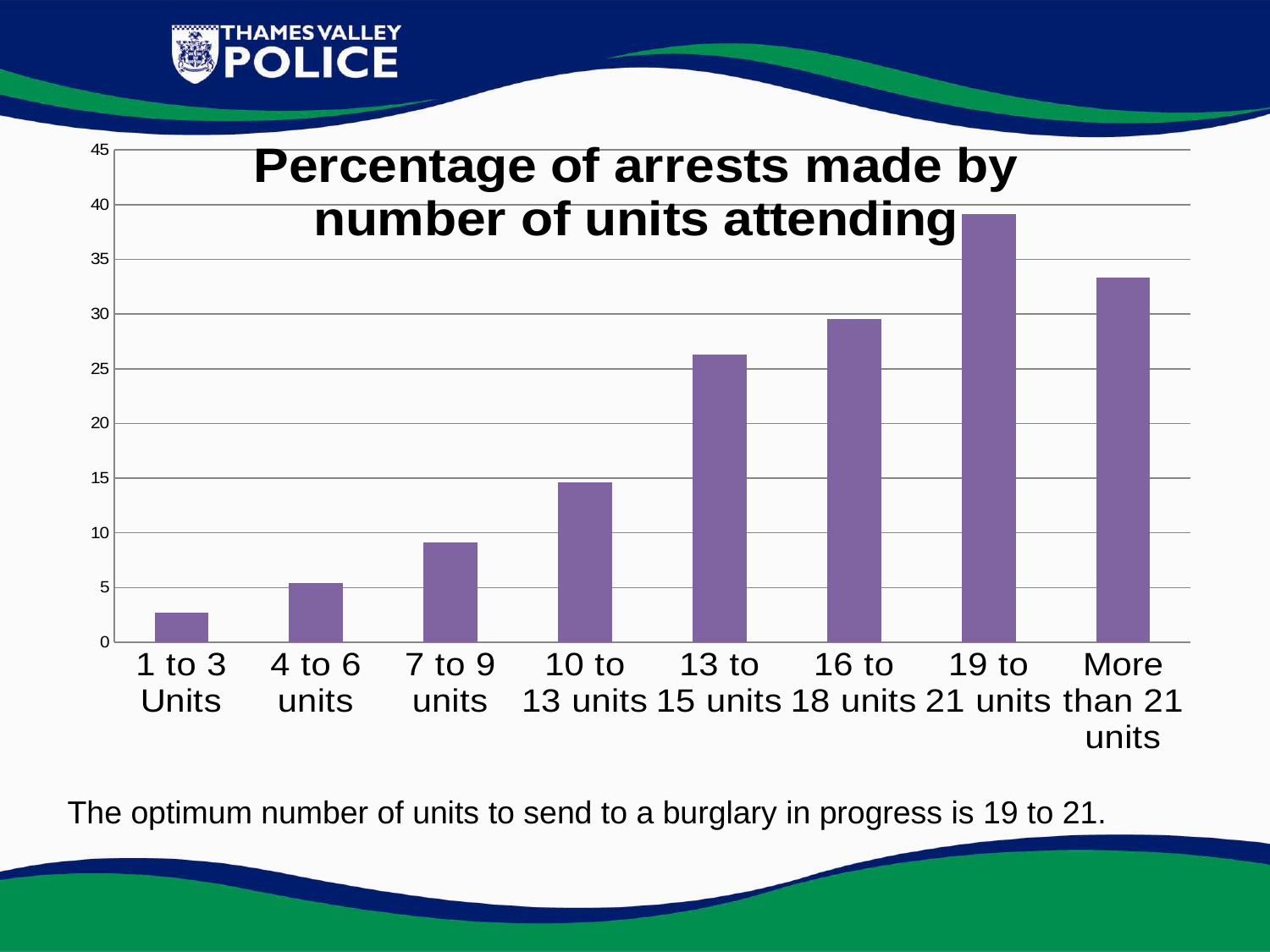
Is the value for 7 to 9 units greater or less than 10? less What is the title of the chart? Percentage of arrests made by number of units attending Is the value for 1 to 3 Units greater or less than 5? less How many categories are shown on the x axis of the chart? 8 Which is larger, the value for 19 to 21 units or the value for More than 21 units? 19 to 21 units What type of chart is shown on the slide? Bar chart Do the values rise or fall from 1 to 3 Units through 19 to 21 units? Rise Which category has the lowest value in the chart? 1 to 3 Units Which category has the highest value in the chart? 19 to 21 units Which is larger, the value for 10 to 13 units or the value for 16 to 18 units? 16 to 18 units Is the value for 13 to 15 units greater or less than 25? greater